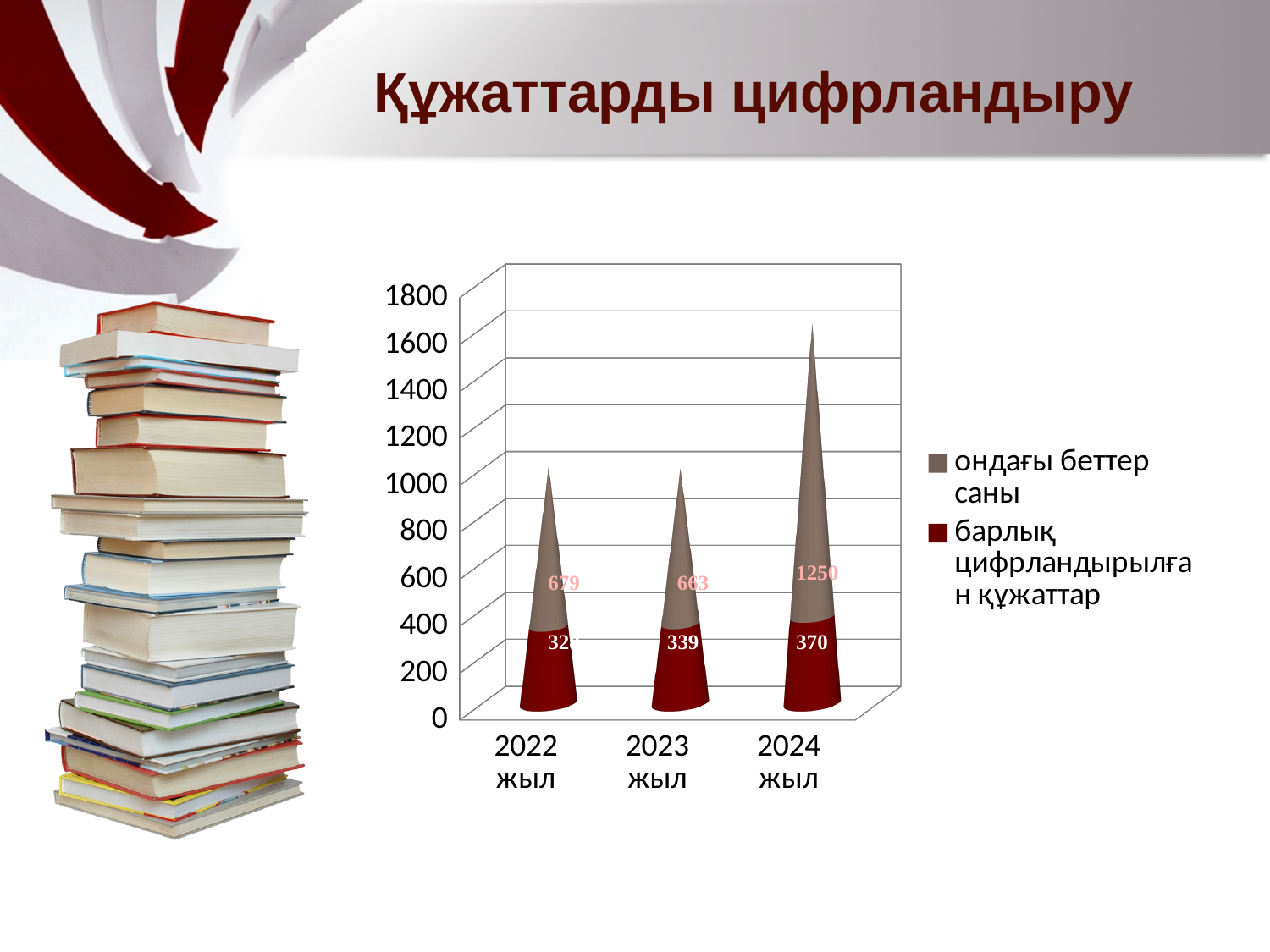
How many years are shown on the x axis of the chart? 3 What is the value of "ондағы беттер саны" for 2024 жыл? 1250 What is the difference between the "ондағы беттер саны" values for 2024 жыл and 2023 жыл? 587 What is the value of "барлық цифрландырылған құжаттар" for 2023 жыл? 339 Which year has the highest value for "ондағы беттер саны"? 2024 жыл What is the total of the stacked bar for 2024 жыл? 1620 Which is larger: "барлық цифрландырылған құжаттар" for 2023 жыл or for 2024 жыл? 2024 жыл Which year has the lowest value for "ондағы беттер саны"? 2023 жыл What is the value of "ондағы беттер саны" for 2022 жыл? 679 What is the value of "барлық цифрландырылған құжаттар" for 2024 жыл? 370 How many series does the legend list? 2 Does the value of "барлық цифрландырылған құжаттар" rise or fall from 2022 жыл to 2024 жыл? rise